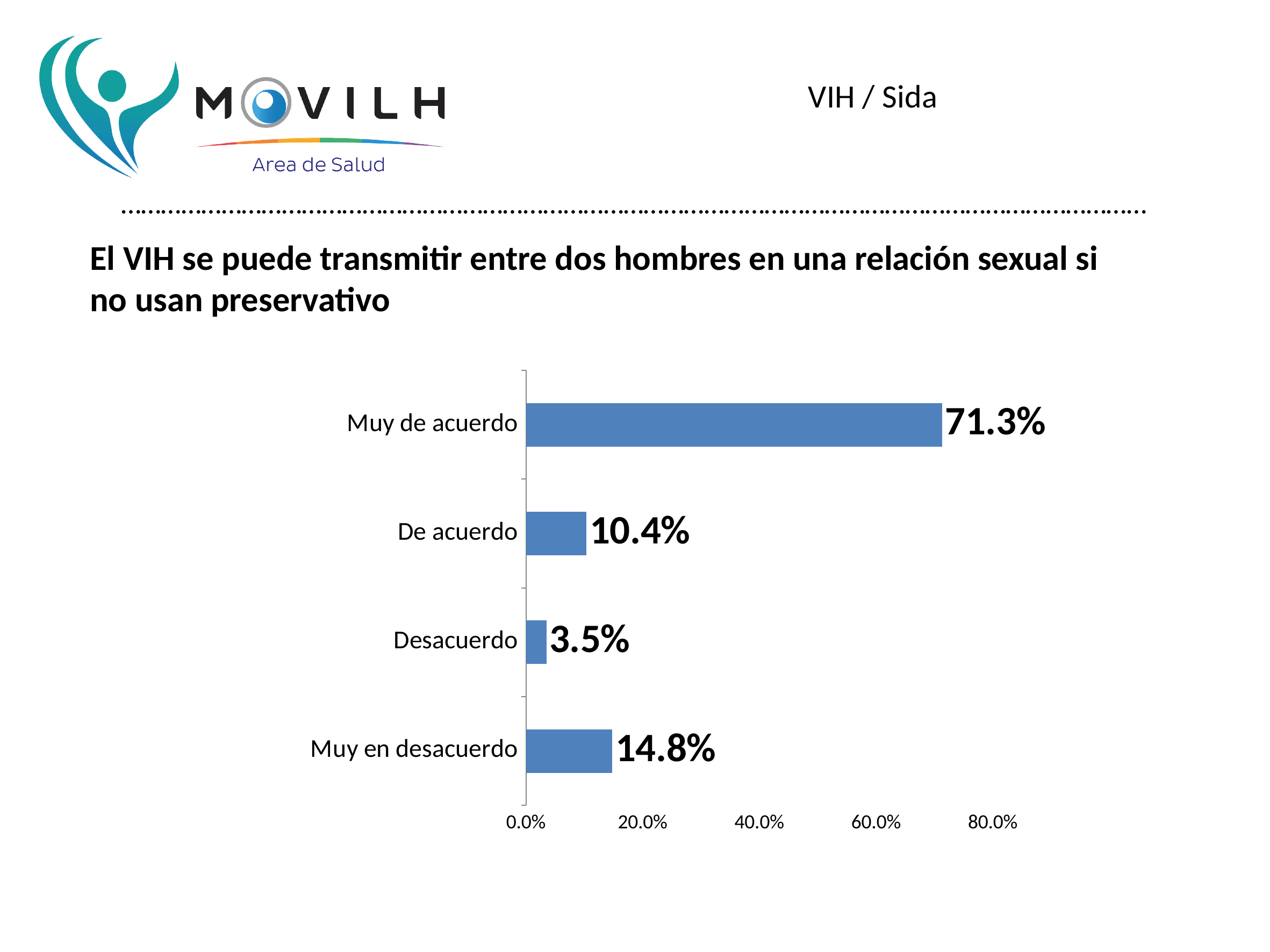
What is the difference between the values for "Muy de acuerdo" and "Muy en desacuerdo"? 56.5% Which category has the lowest value? Desacuerdo What is the value for "Desacuerdo"? 3.5% Which category has the highest value? Muy de acuerdo Is the value for "Muy de acuerdo" greater or less than 60.0%? greater How many categories are shown in the chart? 4 What is the value for "Muy en desacuerdo"? 14.8% What is the value for "Muy de acuerdo"? 71.3% What is the difference between the values for "Muy en desacuerdo" and "De acuerdo"? 4.4% What is the value for "De acuerdo"? 10.4% What kind of chart is shown on the slide? bar chart Which is larger, the value for "De acuerdo" or the value for "Muy en desacuerdo"? Muy en desacuerdo